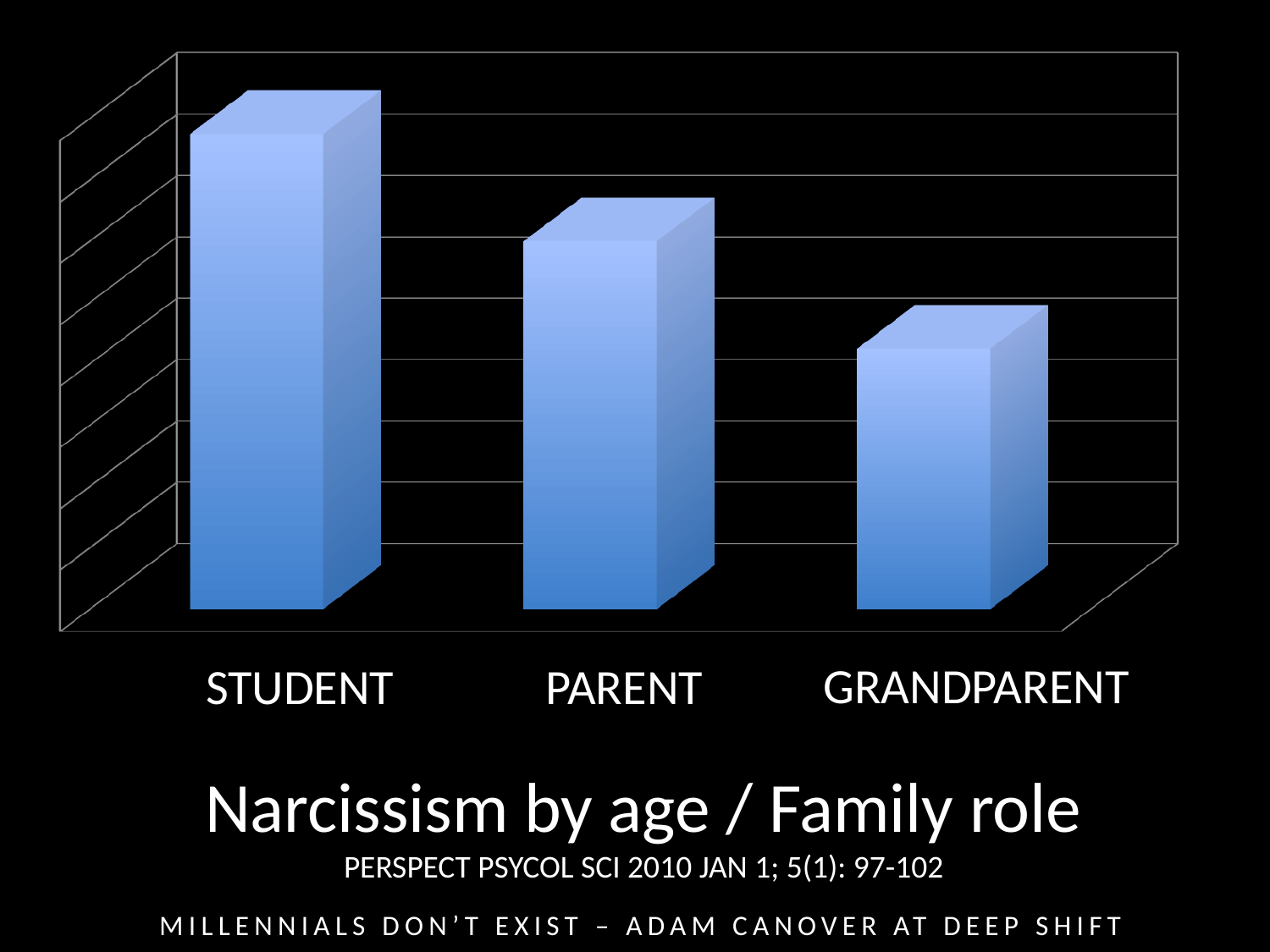
Which bar is taller, PARENT or GRANDPARENT? PARENT Which bar is taller, STUDENT or PARENT? STUDENT What is the title of the chart shown on the slide? Narcissism by age / Family role What are the three category labels on the x axis, from left to right? STUDENT, PARENT, GRANDPARENT What kind of chart is shown on the slide? Bar chart How many categories are shown on the x axis of the chart? 3 Do the bar heights rise or fall moving from STUDENT to GRANDPARENT along the x axis? Fall Which category has the highest bar in the chart? STUDENT Which category has the lowest bar in the chart? GRANDPARENT